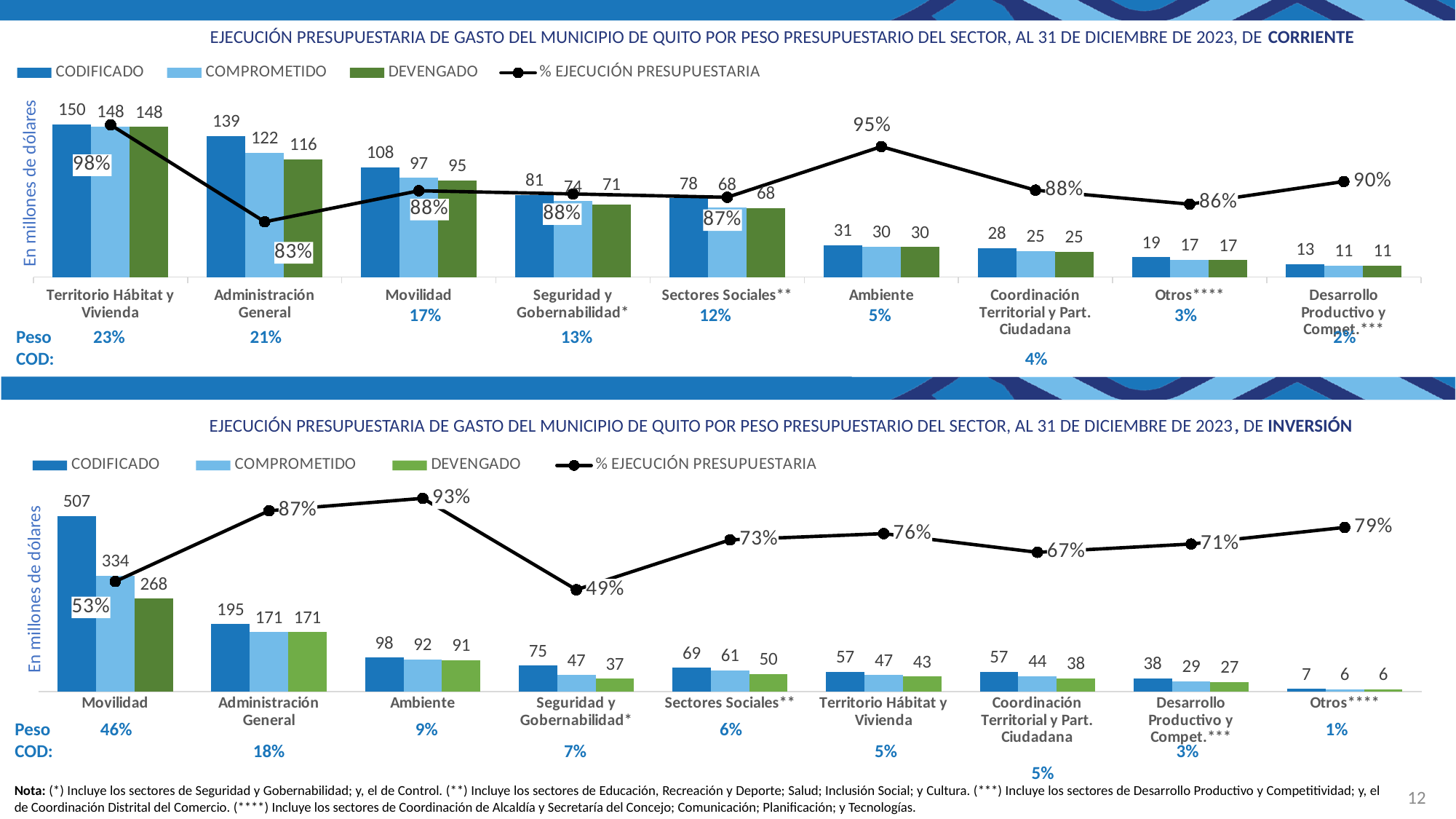
In the INVERSIÓN chart (bottom), what is the % EJECUCIÓN PRESUPUESTARIA for Seguridad y Gobernabilidad*? 49% How many series does the legend of the INVERSIÓN chart (bottom) list? 4 In the CORRIENTE chart (top), which category has the highest % EJECUCIÓN PRESUPUESTARIA? Territorio Hábitat y Vivienda In the INVERSIÓN chart (bottom), what is the CODIFICADO value for Movilidad? 507 In the INVERSIÓN chart (bottom), which is larger: the DEVENGADO value for Sectores Sociales** or for Territorio Hábitat y Vivienda? Sectores Sociales** In the CORRIENTE chart (top), what is the % EJECUCIÓN PRESUPUESTARIA for Administración General? 83% In the INVERSIÓN chart (bottom), what is the difference between the CODIFICADO and DEVENGADO values for Movilidad? 239 In the CORRIENTE chart (top), what is the CODIFICADO value for Territorio Hábitat y Vivienda? 150 In the CORRIENTE chart (top), which category has the lowest CODIFICADO value? Desarrollo Productivo y Compet.*** In the CORRIENTE chart (top), what is the difference between the CODIFICADO and DEVENGADO values for Administración General? 23 How many categories are shown on the x axis of the CORRIENTE chart (top)? 9 In the INVERSIÓN chart (bottom), which category has the highest % EJECUCIÓN PRESUPUESTARIA? Ambiente